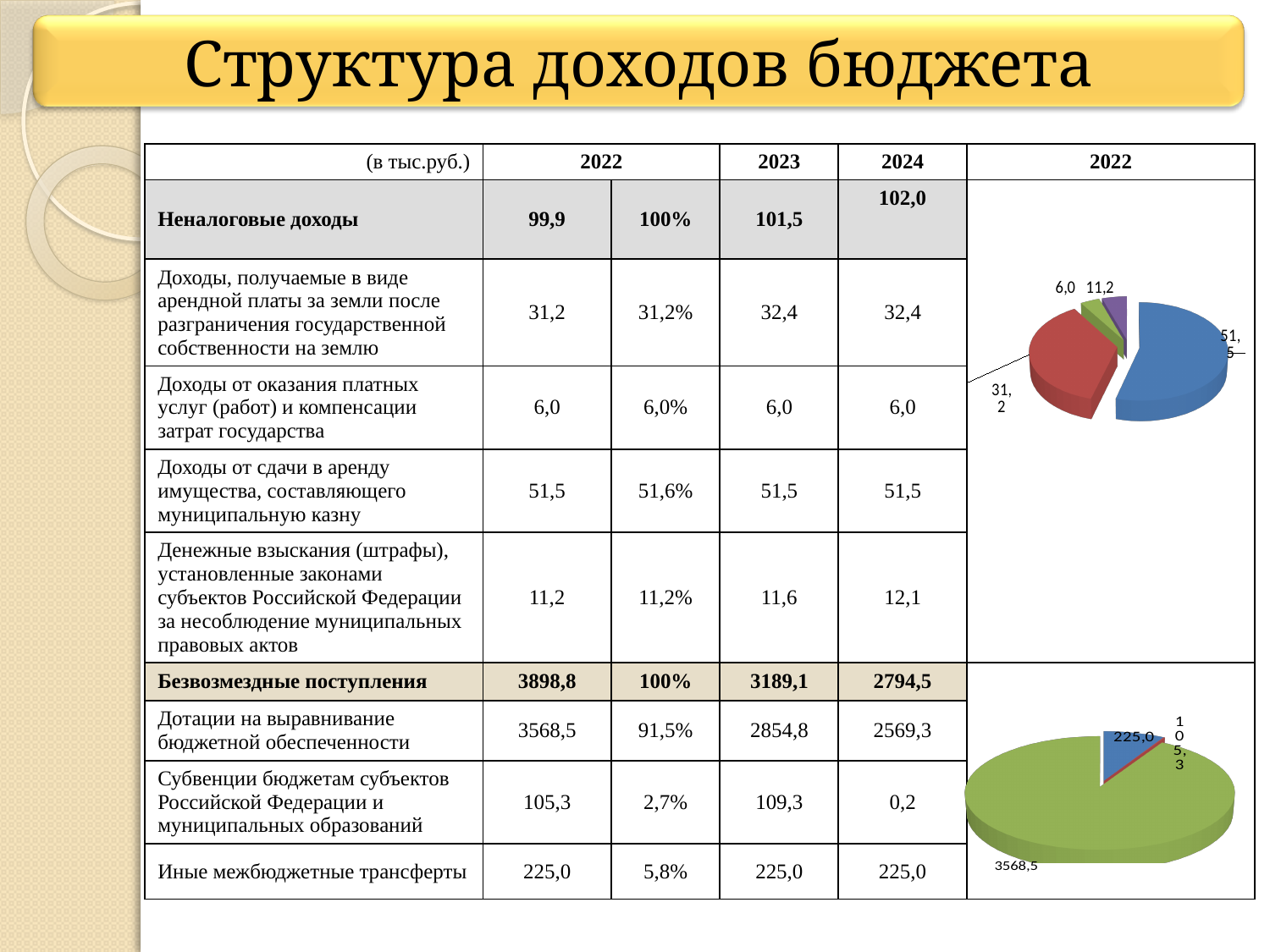
In the lower pie chart, what is the value of the largest slice? 3568,5 In the upper pie chart, what is the difference between the slice labelled 51,5 and the slice labelled 31,2? 20,3 In the upper pie chart, which slice is larger: the one labelled 31,2 or the one labelled 11,2? 31,2 How many slices does the lower pie chart (2022 gratuitous receipts) have? 3 According to the table, what share of the lower pie chart does the slice labelled 3568,5 (Дотации на выравнивание бюджетной обеспеченности) represent? 91,5% How many slices does the upper pie chart (2022 non-tax revenues) have? 4 What year do both pie charts on the slide represent, according to their heading? 2022 In the upper pie chart, what is the value of the smallest slice? 6,0 In the lower pie chart, what is the value of the smallest slice? 105,3 In the lower pie chart, what is the difference between the slice labelled 3568,5 and the slice labelled 225,0? 3343,5 What kind of chart is the upper chart on the right of the slide? pie chart In the upper pie chart, what is the value of the largest slice? 51,5